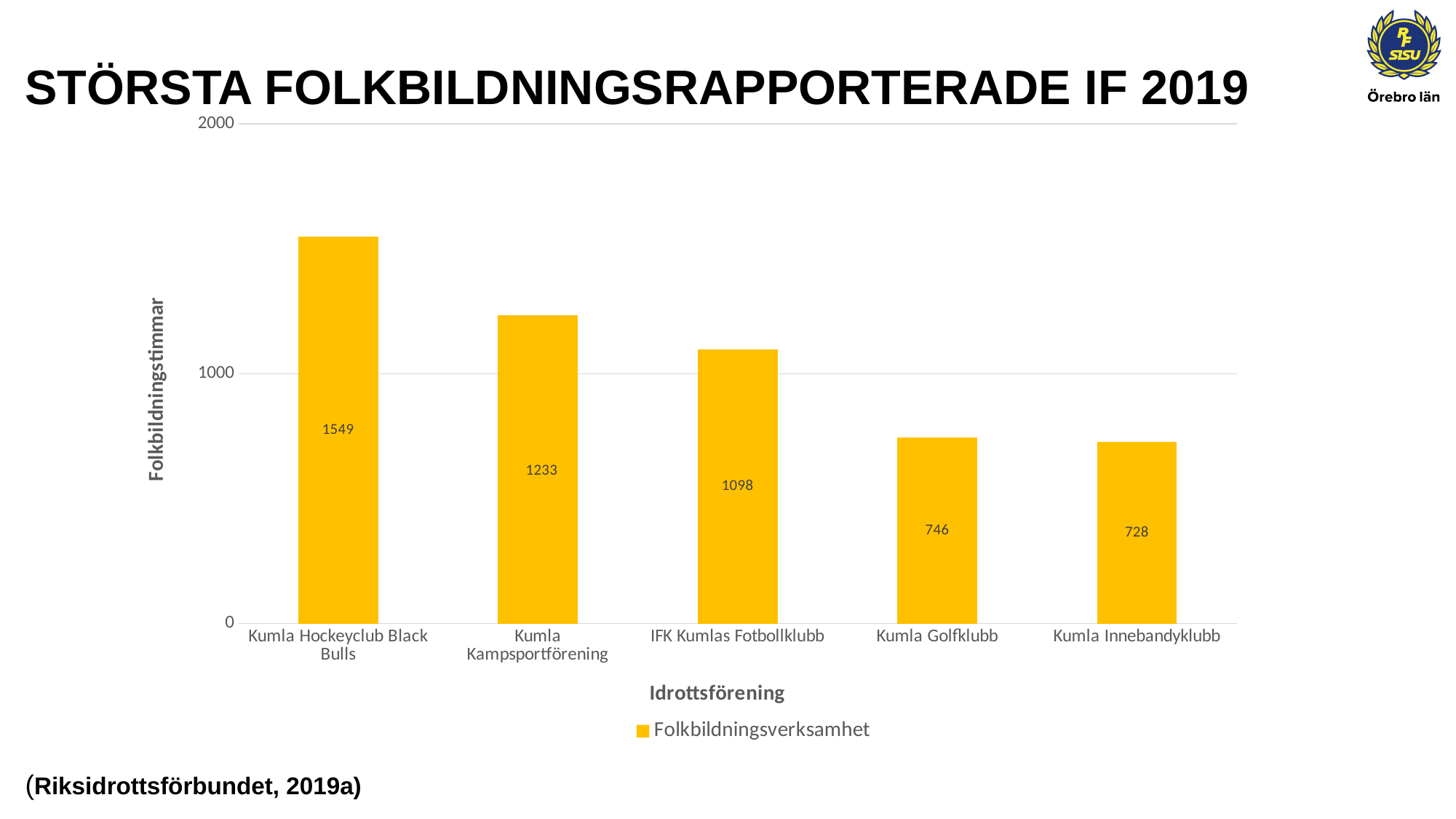
Which category has the lowest value? Kumla Innebandyklubb How many categories are shown on the x axis? 5 What is the label of the y axis? Folkbildningstimmar What is the value for IFK Kumlas Fotbollklubb? 1098 What is the value for Kumla Innebandyklubb? 728 What kind of chart is shown on the slide? bar chart Which is larger, the value for Kumla Kampsportförening or the value for IFK Kumlas Fotbollklubb? Kumla Kampsportförening What is the value for Kumla Hockeyclub Black Bulls? 1549 What is the difference between the values for Kumla Golfklubb and Kumla Innebandyklubb? 18 Which category has the highest value? Kumla Hockeyclub Black Bulls Is the value for Kumla Golfklubb greater or less than 1000? less What is the difference between the values for Kumla Hockeyclub Black Bulls and Kumla Kampsportförening? 316